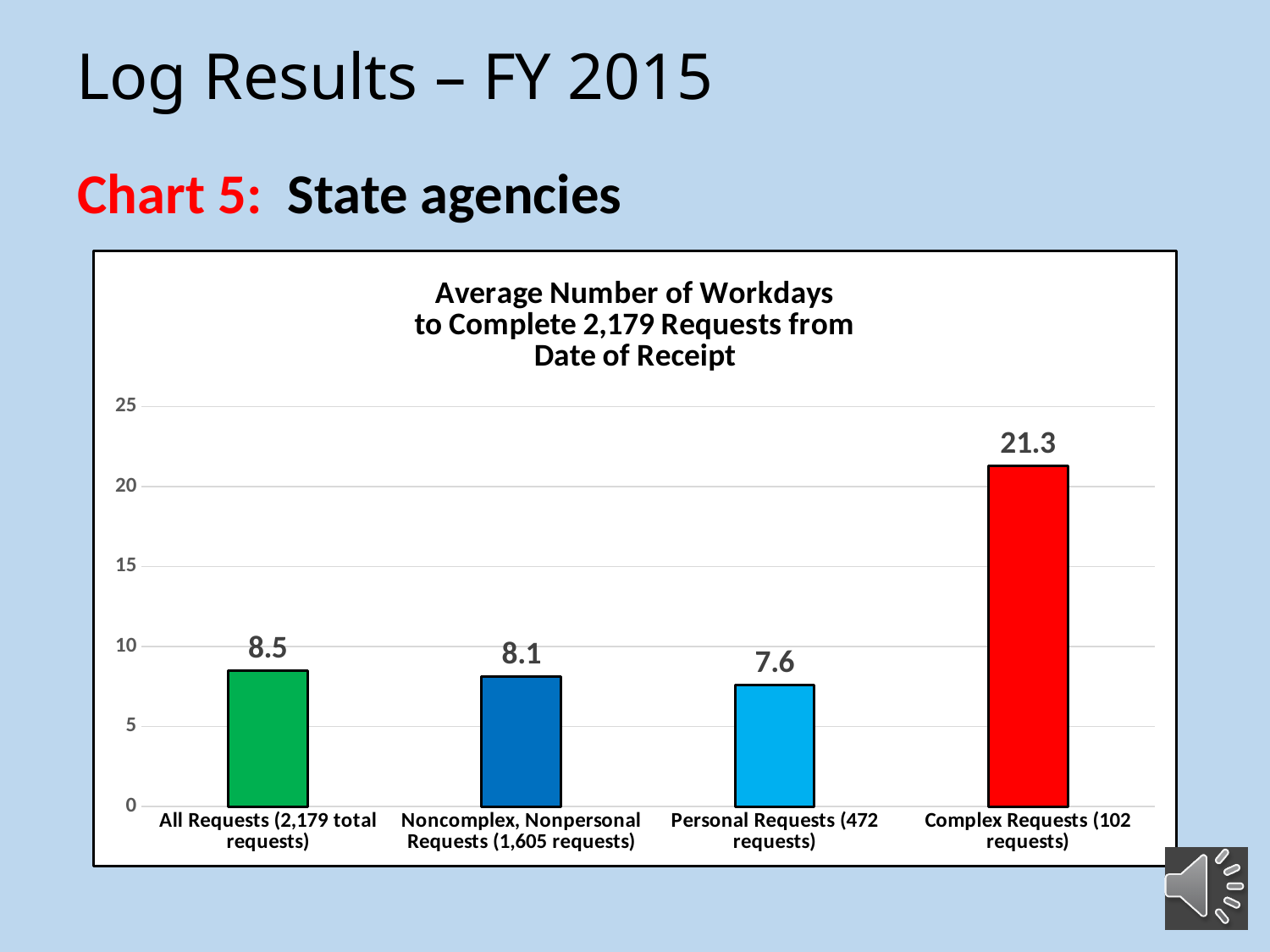
Which has a higher average number of workdays, Complex Requests or Personal Requests? Complex Requests Which category has the highest average number of workdays? Complex Requests What is the difference in average workdays between Complex Requests and All Requests? 12.8 What is the average number of workdays for Noncomplex, Nonpersonal Requests? 8.1 Which category has the lowest average number of workdays? Personal Requests What is the average number of workdays for All Requests? 8.5 What is the average number of workdays for Personal Requests? 7.6 How many categories are shown in the chart? 4 What type of chart is shown on the slide? Bar chart What is the average number of workdays for Complex Requests? 21.3 Is the value for Complex Requests greater or less than 20? greater What is the difference in average workdays between Noncomplex, Nonpersonal Requests and Personal Requests? 0.5